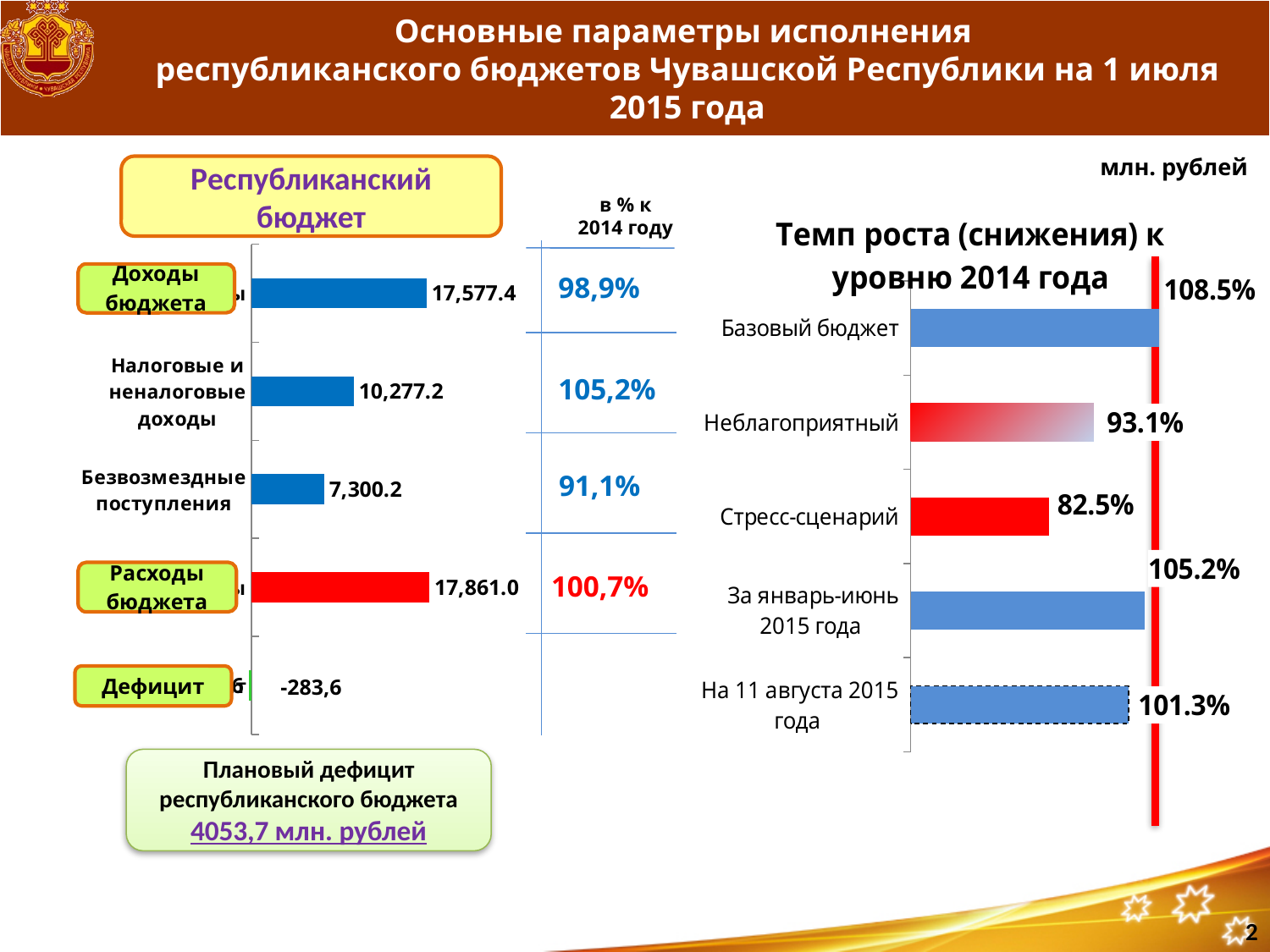
On the left chart (Республиканский бюджет), what is the difference between Расходы бюджета and Доходы бюджета? 283.6 On the right chart (Темп роста (снижения) к уровню 2014 года), how many categories are plotted? 5 On the left chart (Республиканский бюджет), what is the value for Доходы бюджета? 17,577.4 On the left chart (Республиканский бюджет), which is larger: Доходы бюджета or Расходы бюджета? Расходы бюджета On the left chart (Республиканский бюджет), what is the value for Безвозмездные поступления? 7,300.2 On the right chart (Темп роста (снижения) к уровню 2014 года), which category has the lowest value? Стресс-сценарий What kind of chart is the right chart (Темп роста (снижения) к уровню 2014 года)? Bar chart On the left chart (Республиканский бюджет), what is the value for Налоговые и неналоговые доходы? 10,277.2 On the right chart (Темп роста (снижения) к уровню 2014 года), what is the value for Стресс-сценарий? 82.5% On the right chart (Темп роста (снижения) к уровню 2014 года), which category has the highest value? Базовый бюджет On the left chart (Республиканский бюджет), what is the value for Расходы бюджета? 17,861.0 On the right chart (Темп роста (снижения) к уровню 2014 года), what is the value for Базовый бюджет? 108.5%